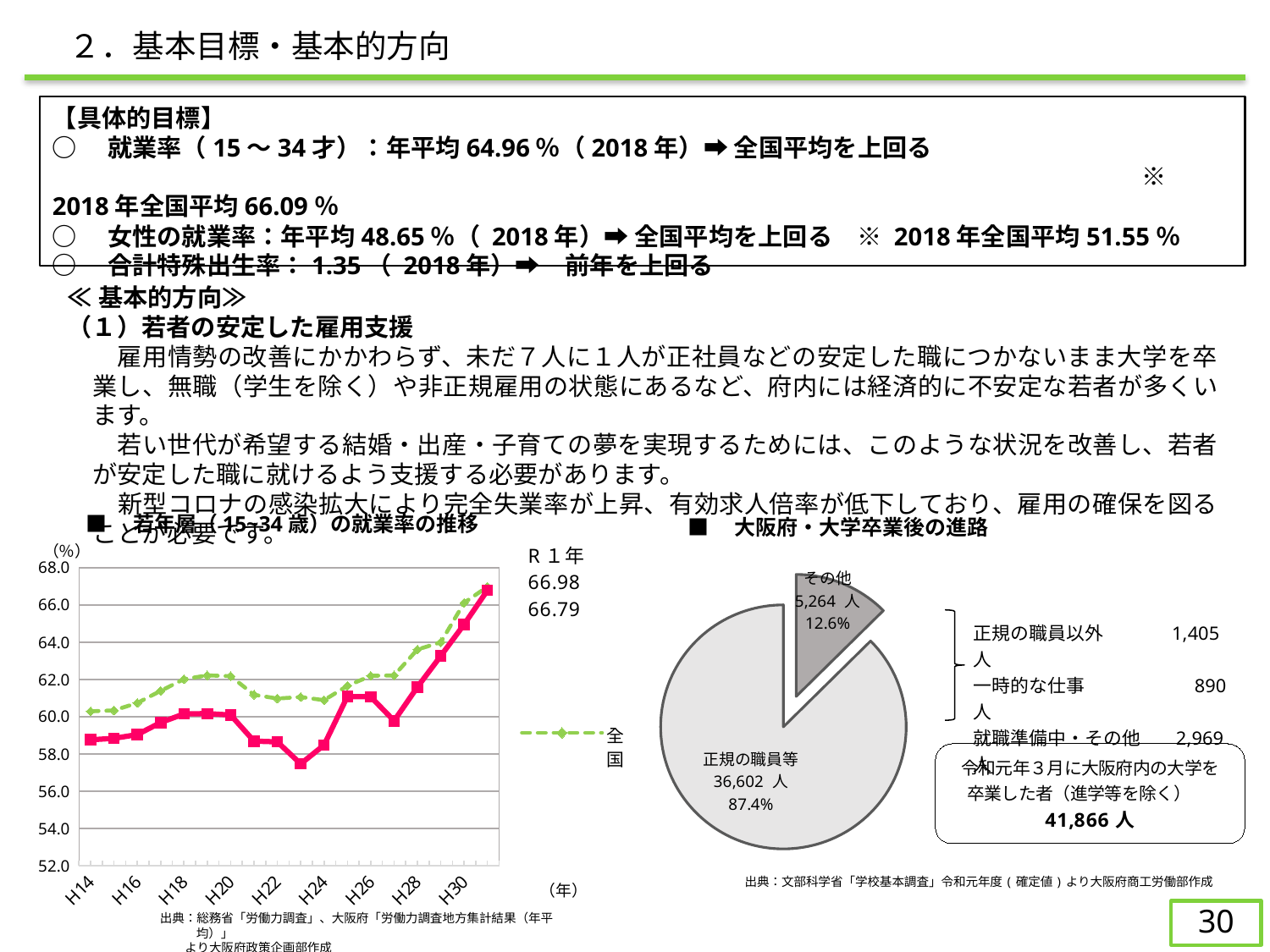
In the line chart 若年層（15-34歳）の就業率の推移, what two values are printed for R1年? 66.98 and 66.79 In the pie chart 大阪府・大学卒業後の進路, which slice is the largest? 正規の職員等 In the pie chart 大阪府・大学卒業後の進路, what is the total number of graduates shown in the box? 41,866 人 In the pie chart 大阪府・大学卒業後の進路, how many people are listed under 正規の職員以外? 1,405 人 In the pie chart 大阪府・大学卒業後の進路, how many more people are in 正規の職員等 than in その他? 31,338 人 What kind of chart is the chart titled 大阪府・大学卒業後の進路? pie chart In the pie chart 大阪府・大学卒業後の進路, what share of the pie is the その他 slice? 12.6% In the line chart 若年層（15-34歳）の就業率の推移, is the value of the solid pink line at H23 greater or less than 58.0? less In the pie chart 大阪府・大学卒業後の進路, how many people are in the 正規の職員等 slice? 36,602 人 In the pie chart 大阪府・大学卒業後の進路, how many people are listed under 一時的な仕事? 890 人 In the line chart 若年層（15-34歳）の就業率の推移, in which year does the solid pink line reach its lowest point? H23 What kind of chart is the chart titled 若年層（15-34歳）の就業率の推移? line chart